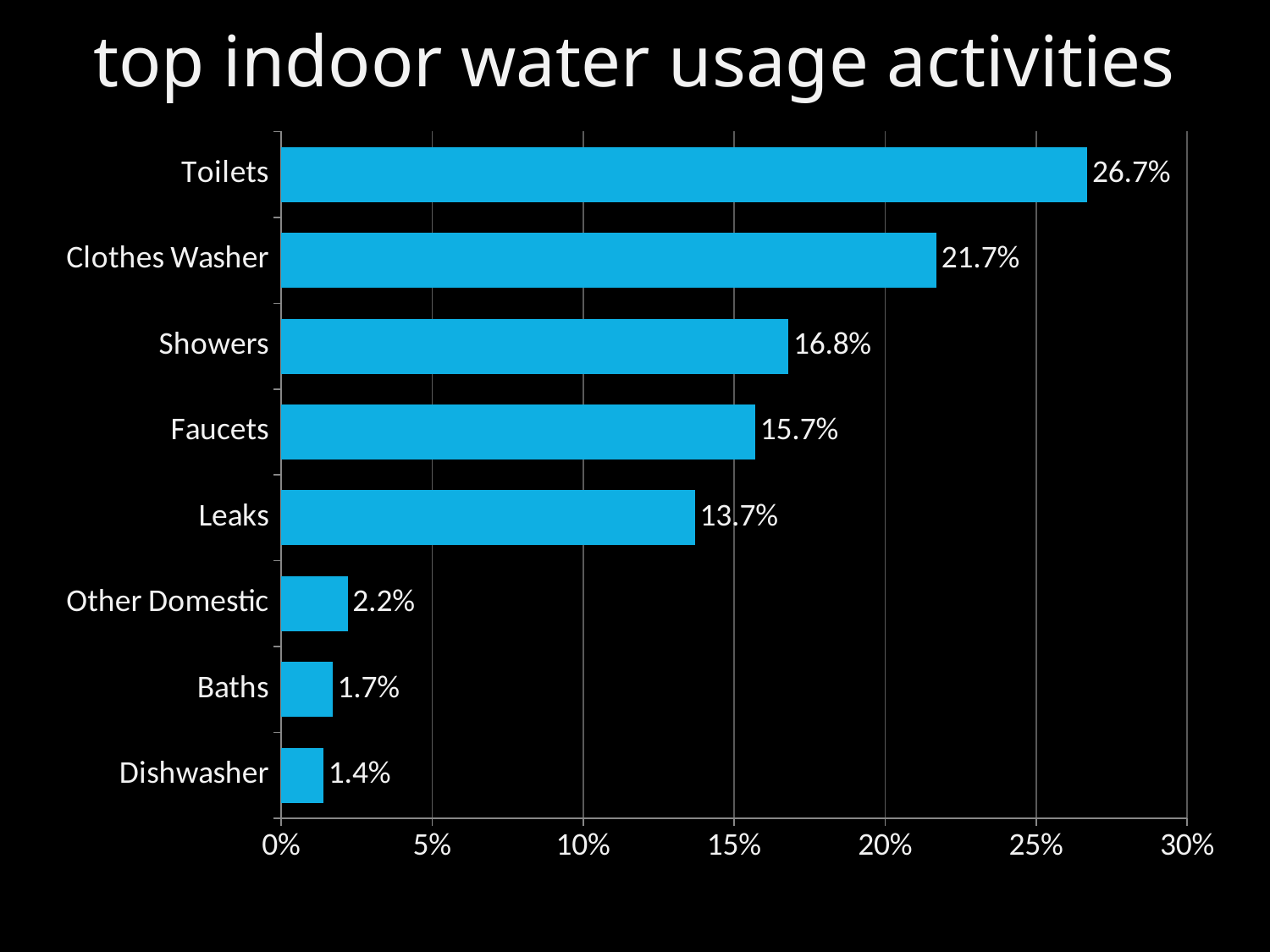
Is the value for Clothes Washer greater or less than 20%? greater What is the title of the chart? top indoor water usage activities What is the difference between the values for Showers and Faucets? 1.1% Which activity has the lowest value? Dishwasher Which activity has the highest value? Toilets What is the difference between the values for Toilets and Clothes Washer? 5.0% What is the value for Leaks? 13.7% What is the value for Dishwasher? 1.4% What is the value for Toilets? 26.7% What kind of chart is shown on the slide? Bar chart Which is larger, the value for Showers or the value for Leaks? Showers How many activities are shown in the chart? 8